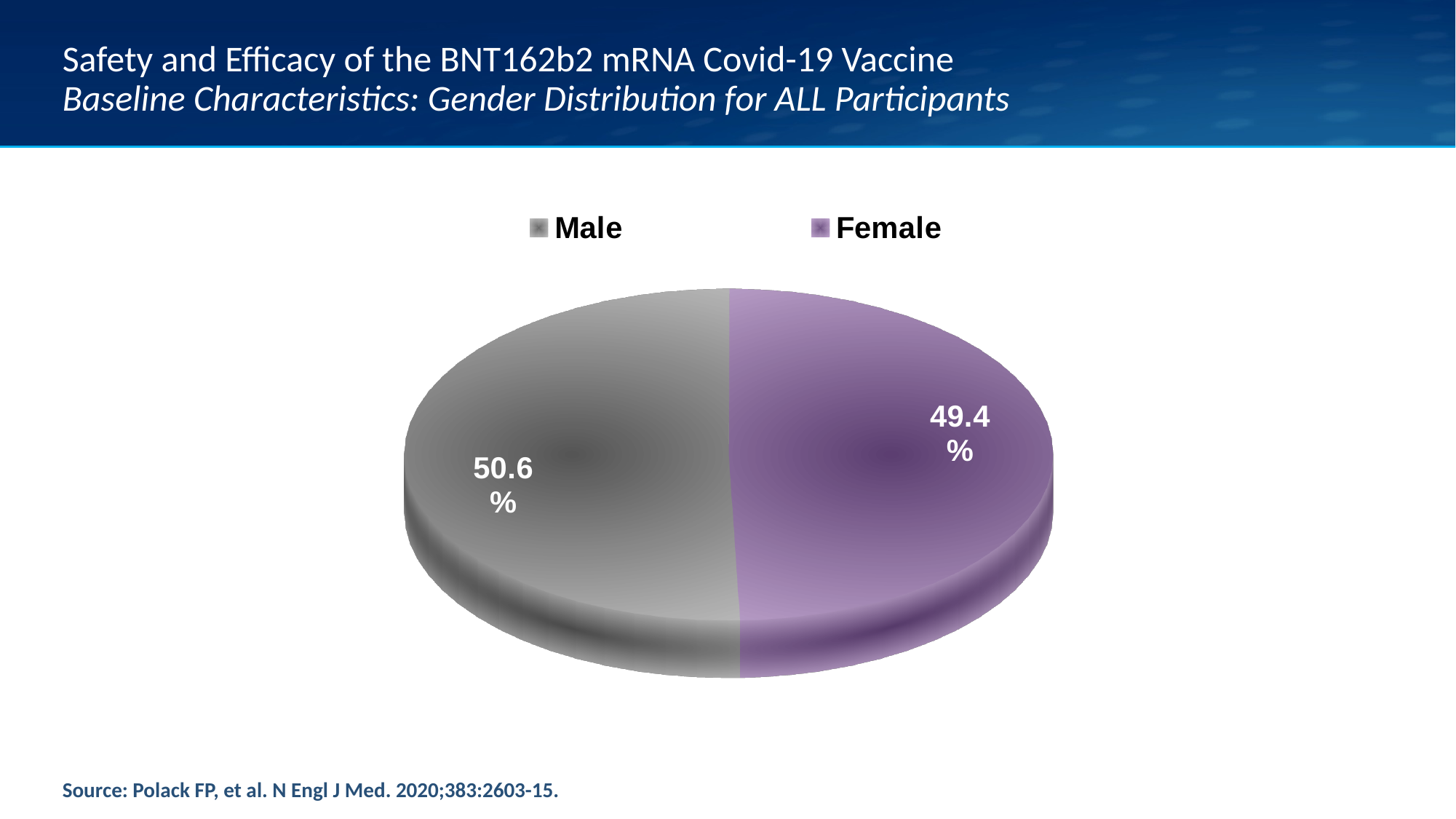
What percentage of participants are Female? 49.4% What are the two legend entries of the chart? Male and Female What percentage of participants are Male? 50.6% Which gender has the larger share of participants? Male What is the total of the two slices shown in the pie chart? 100% Which colour represents Female in the pie chart? purple How many categories does the pie chart show? 2 What is the difference in percentage points between the Male and Female shares? 1.2 What kind of chart is shown on the slide? pie chart Which gender has the smaller share of participants? Female Is the Male share larger or smaller than the Female share? larger